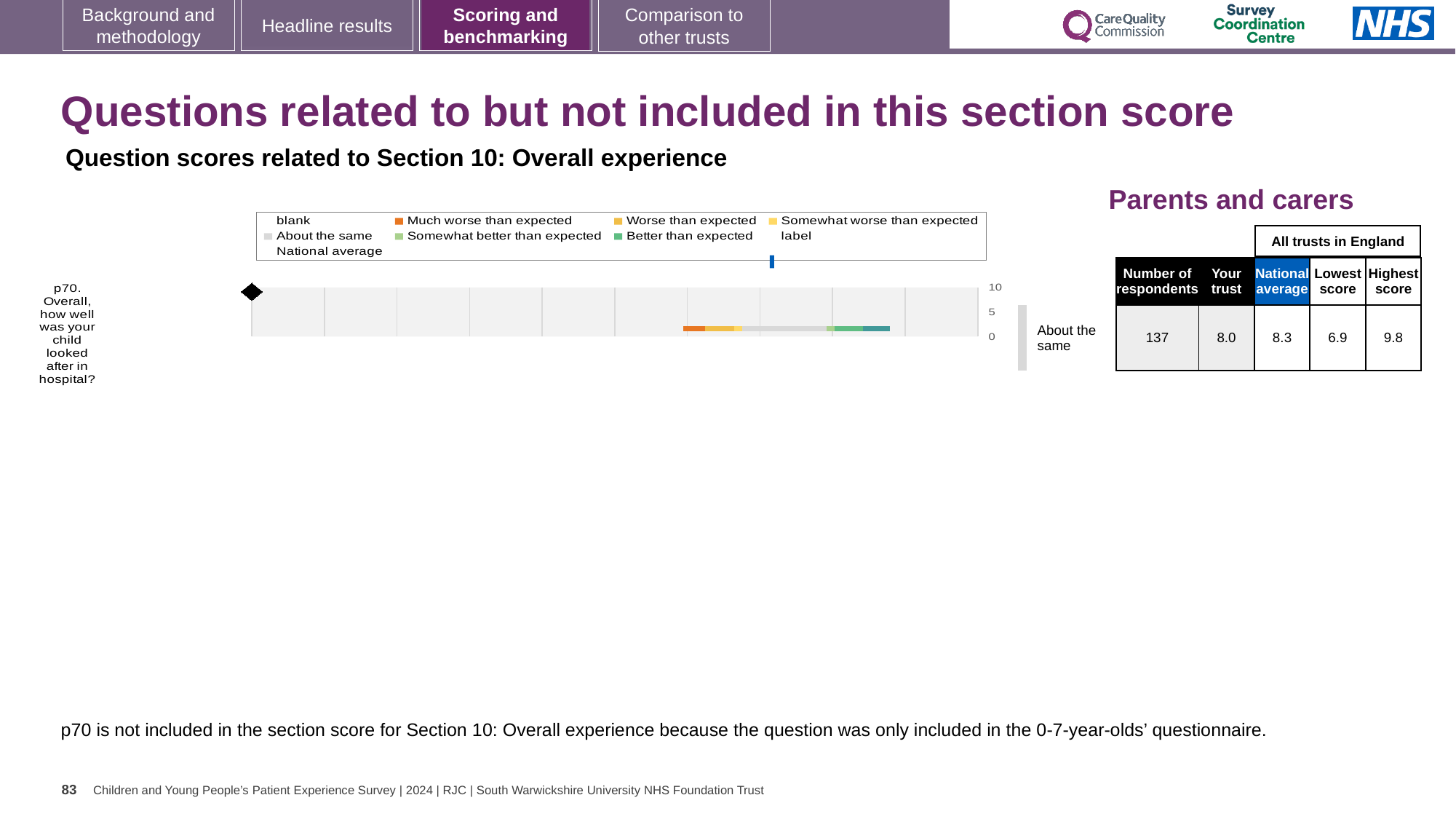
What is the 'Your trust' score for p70? 8.0 Which question is plotted in the chart? p70. Overall, how well was your child looked after in hospital? How many questions are plotted in the chart on this slide? 1 How many entries does the chart legend list? 9 What is the number of respondents for p70? 137 What is the highest score among all trusts in England for p70? 9.8 What is the lowest score among all trusts in England for p70? 6.9 What comparison category is shown to the right of the bar for p70? About the same For p70, what is the difference between the highest score and the lowest score among all trusts in England? 2.9 What is the national average score for p70? 8.3 For p70, which is larger: the 'Your trust' score or the national average? National average What kind of chart is used to show the p70 result on this slide? Bar chart